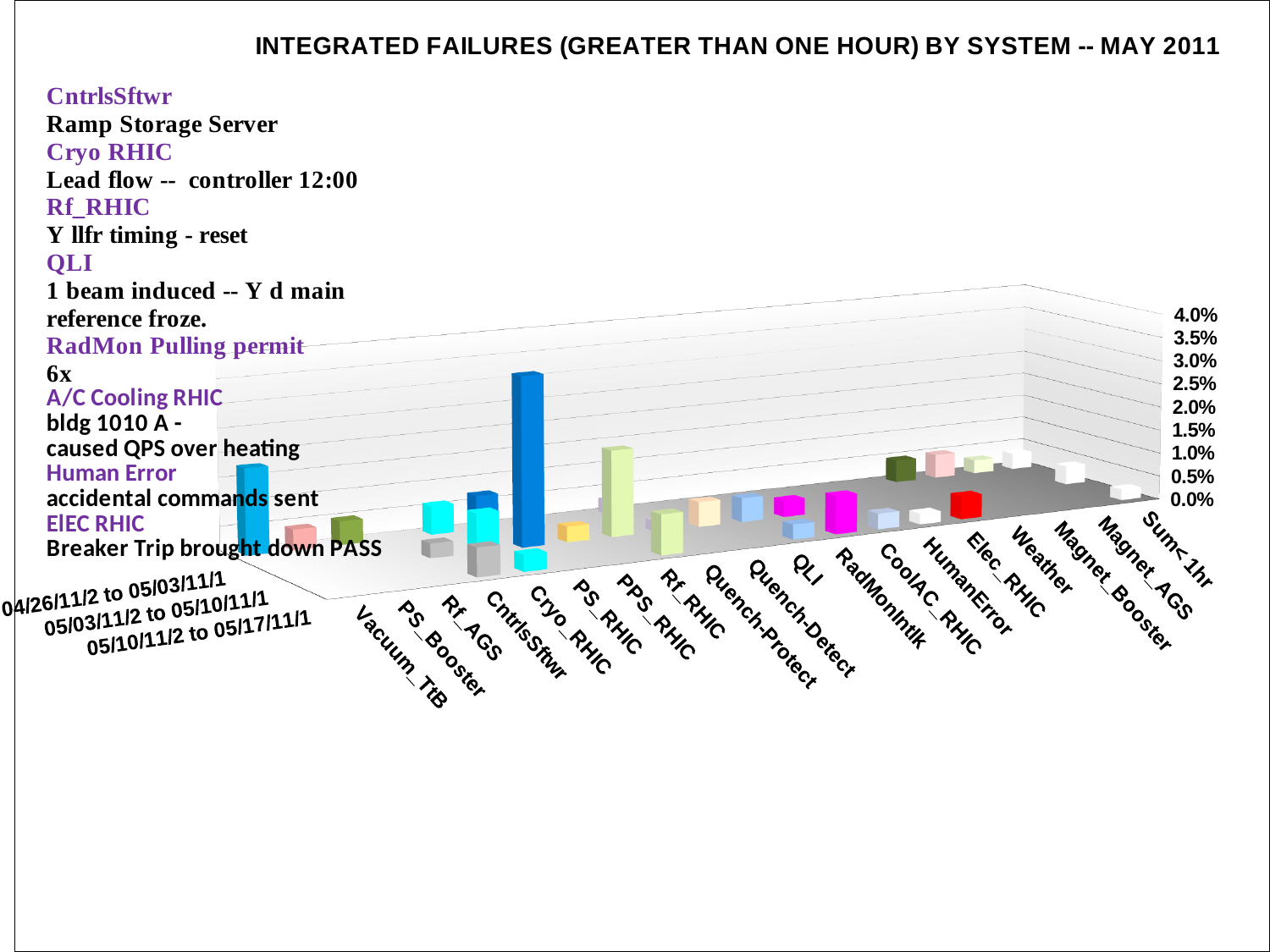
What is the maximum value shown on the vertical axis of the chart? 4.0% What is the first category on the x axis of the chart? Vacuum_TtB How many system categories are shown along the x axis of the chart? 19 Which system has the tallest bar in the chart? PS_RHIC Which is larger, the tallest bar for Cryo_RHIC or the tallest bar for Vacuum_TtB? Vacuum_TtB What is the title of the chart? INTEGRATED FAILURES (GREATER THAN ONE HOUR) BY SYSTEM -- MAY 2011 What kind of chart is shown on the slide? bar chart Which is larger, the tallest bar for PPS_RHIC or the tallest bar for QLI? QLI Is the tallest bar for Cryo_RHIC greater or less than 1.0%? less How many date-range series does the chart show? 3